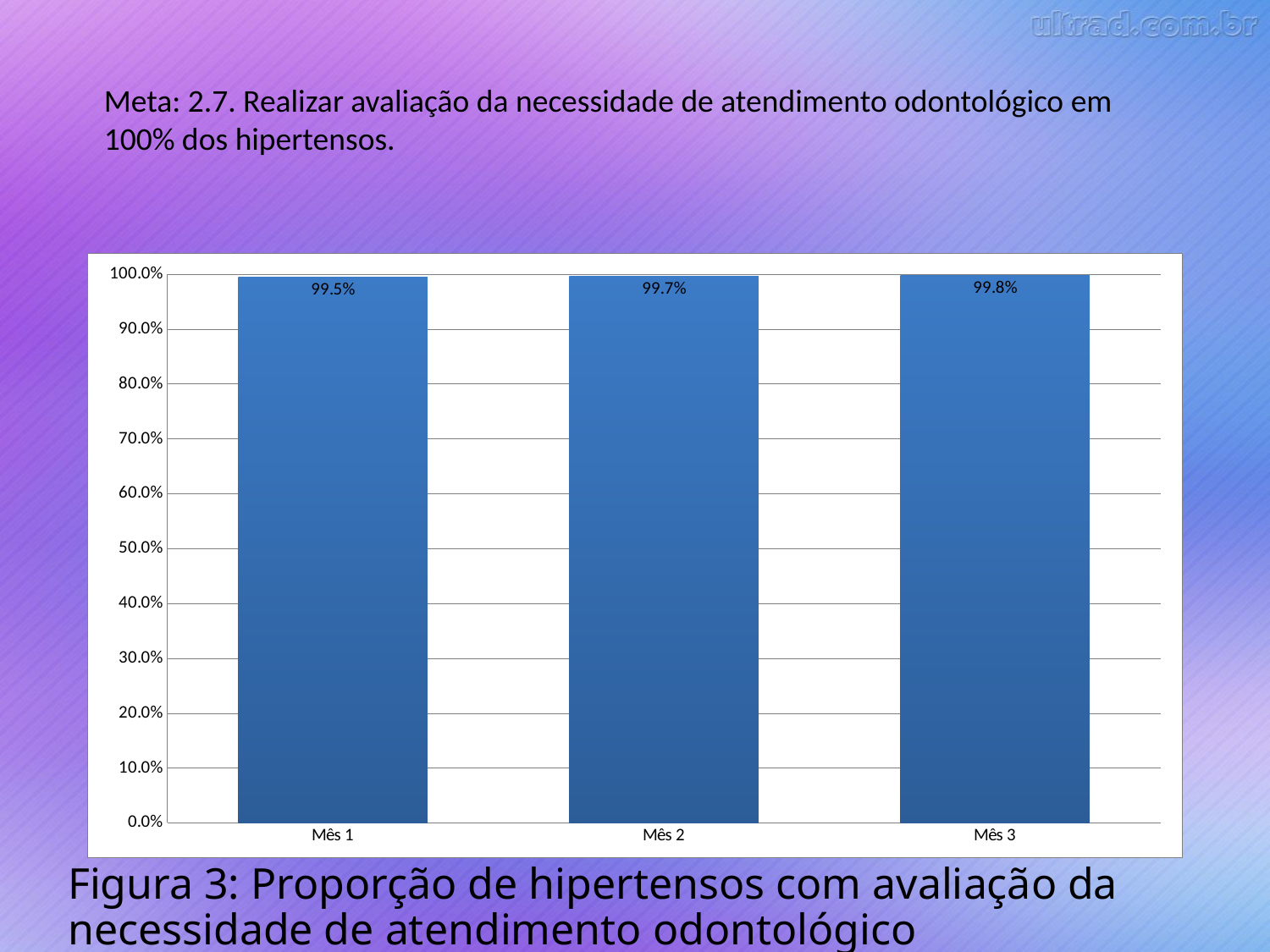
Which month has the highest value? Mês 3 What is the value for Mês 1? 99.5% Which month has the lowest value? Mês 1 Is the value for Mês 1 greater or less than 90.0%? greater What is the difference between the values for Mês 3 and Mês 1? 0.3% What is the value for Mês 3? 99.8% Do the values rise or fall from Mês 1 to Mês 3? rise Which is larger, the value for Mês 2 or the value for Mês 3? Mês 3 How many months are shown on the x axis? 3 What is the value for Mês 2? 99.7% What kind of chart is shown on the slide? bar chart What is the difference between the values for Mês 2 and Mês 1? 0.2%